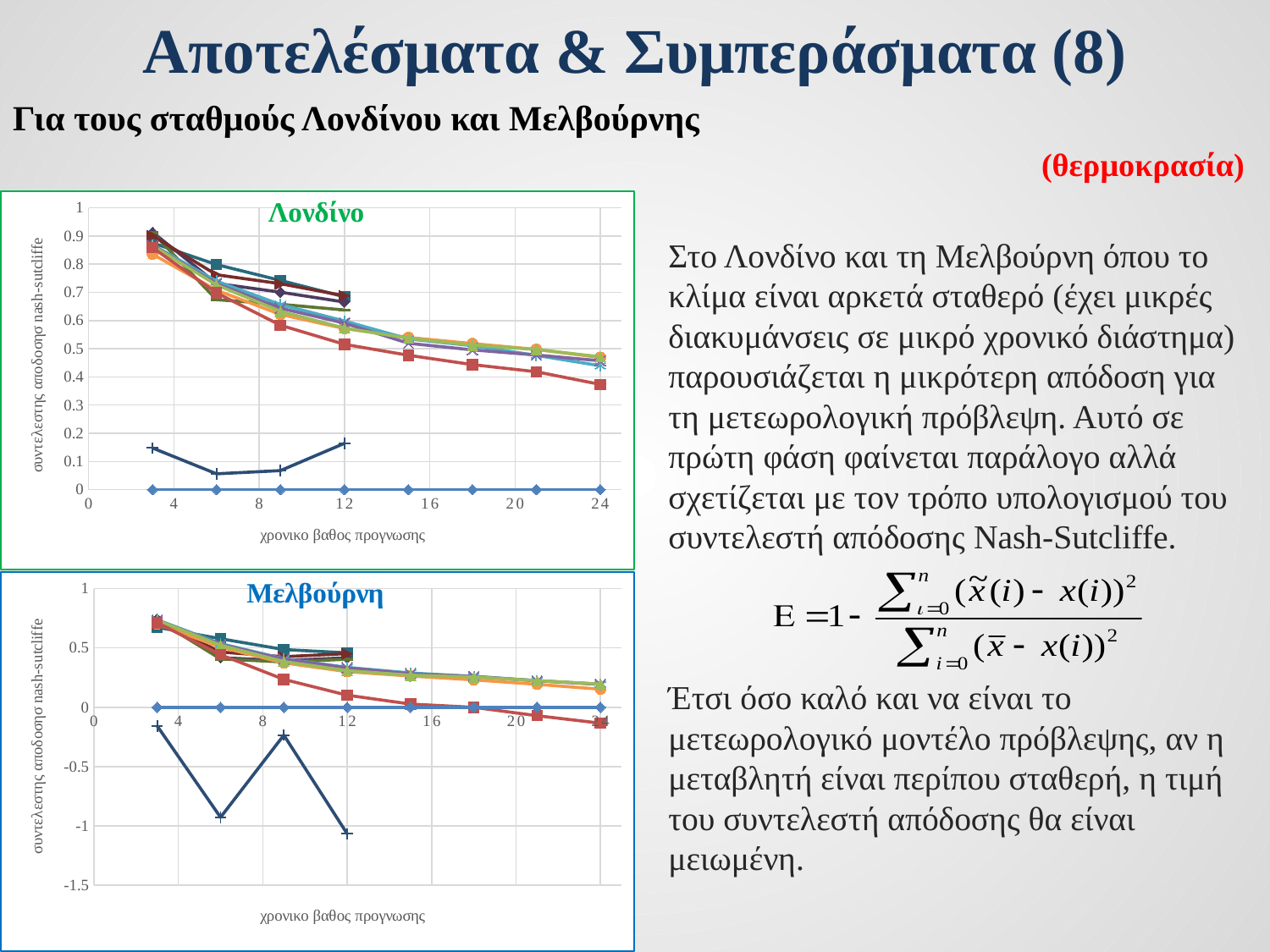
In the Λονδίνο chart, do the values of the upper group of lines rise or fall as the x axis increases from 4 to 24? Fall What is the x-axis label of the Μελβούρνη chart? χρονικο βαθος προγνωσης What type of chart is the top chart titled Λονδίνο? Line chart In the Μελβούρνη chart, is the value of the plus-marker line at x = 12 greater or less than -0.5? less In the Μελβούρνη chart, do the values of the upper group of lines rise or fall as the x axis increases from 4 to 24? Fall What type of chart is the bottom chart titled Μελβούρνη? Line chart In the Λονδίνο chart, is the value of the red square-marker line at x = 24 greater or less than 0.5? less In the Μελβούρνη chart, is the value of the red square-marker line at x = 24 greater or less than 0? less What is the title of the top chart on the slide? Λονδίνο